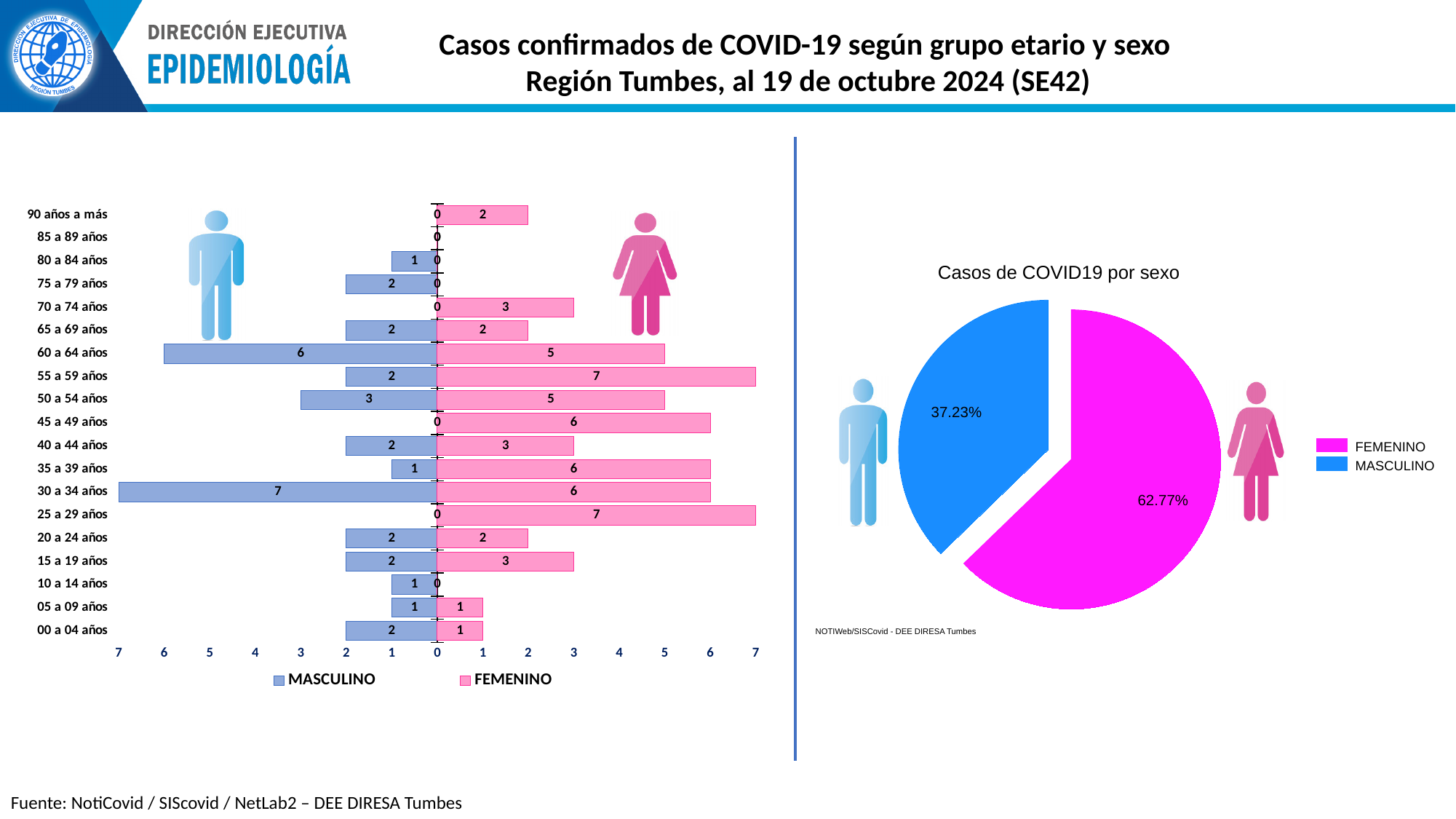
In the left bar chart, which is larger for the 50 a 54 años group, MASCULINO or FEMENINO? FEMENINO In the pie chart 'Casos de COVID19 por sexo', what share is MASCULINO? 37.23% In the pie chart 'Casos de COVID19 por sexo', which slice is larger, FEMENINO or MASCULINO? FEMENINO In the pie chart 'Casos de COVID19 por sexo', what share is FEMENINO? 62.77% In the left bar chart, what is the difference between the FEMENINO and MASCULINO values for the 45 a 49 años group? 6 In the left bar chart, how many MASCULINO cases are there in the 60 a 64 años group? 6 How many age groups are shown in the left bar chart? 19 In the left bar chart, how many FEMENINO cases are there in the 55 a 59 años group? 7 What kind of chart is the chart on the left of the slide? Bar chart In the pie chart 'Casos de COVID19 por sexo', what colour is the MASCULINO slice? Blue How many series does the legend of the left bar chart list? 2 In the left bar chart, which age group has the highest MASCULINO value? 30 a 34 años